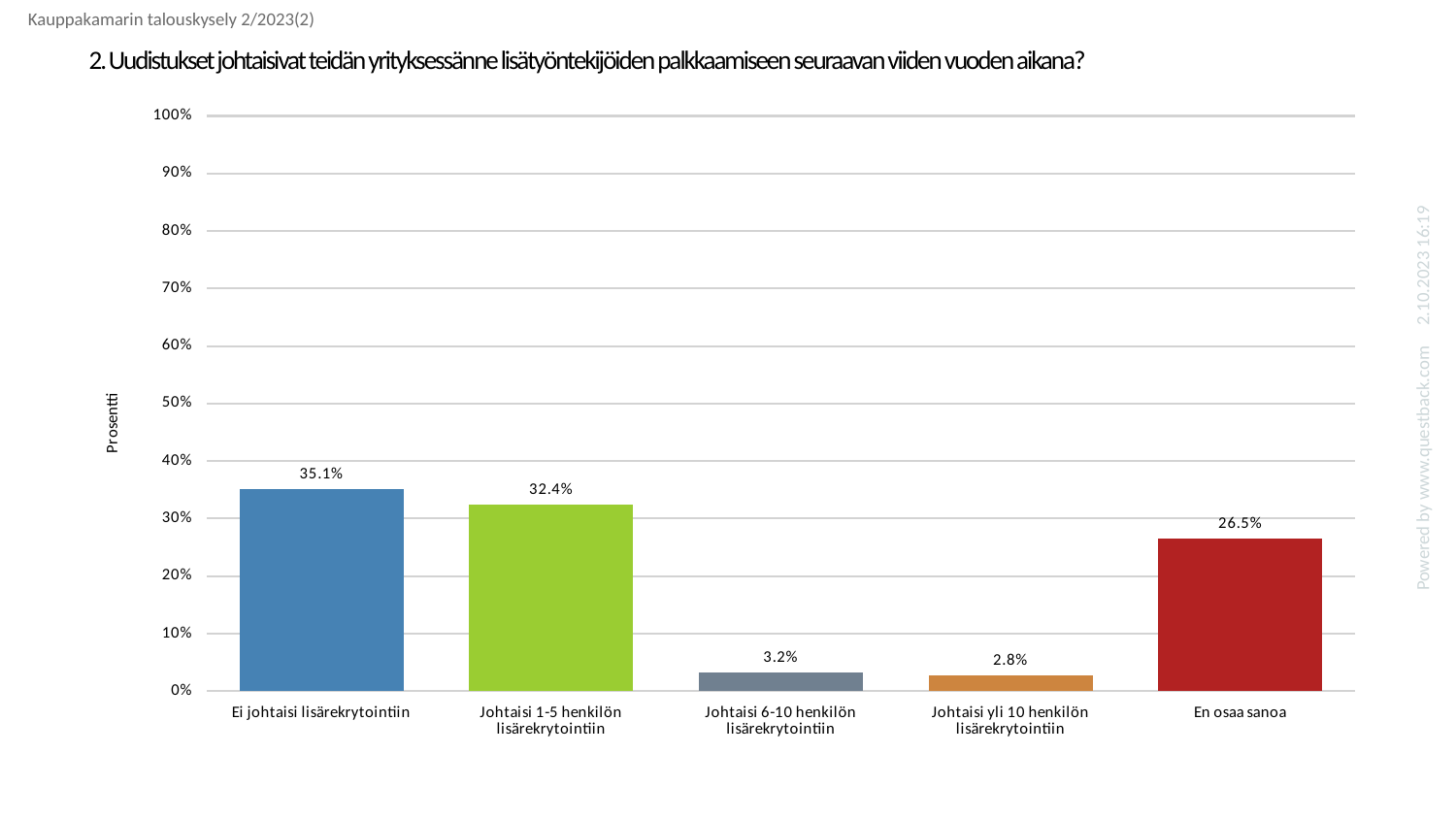
What is the difference between "Ei johtaisi lisärekrytointiin" and "Johtaisi 1-5 henkilön lisärekrytointiin"? 2.7% Which category has the highest value? Ei johtaisi lisärekrytointiin What kind of chart is shown on the slide? bar chart How many categories are shown on the x axis? 5 Which category has the lowest value? Johtaisi yli 10 henkilön lisärekrytointiin Is the value for "Johtaisi 6-10 henkilön lisärekrytointiin" greater or less than 10%? less Which is larger: "Johtaisi 1-5 henkilön lisärekrytointiin" or "En osaa sanoa"? Johtaisi 1-5 henkilön lisärekrytointiin What is the value for "Johtaisi 1-5 henkilön lisärekrytointiin"? 32.4% What is the label of the y axis? Prosentti What is the value for "En osaa sanoa"? 26.5% What is the value for "Ei johtaisi lisärekrytointiin"? 35.1% What is the value for "Johtaisi yli 10 henkilön lisärekrytointiin"? 2.8%